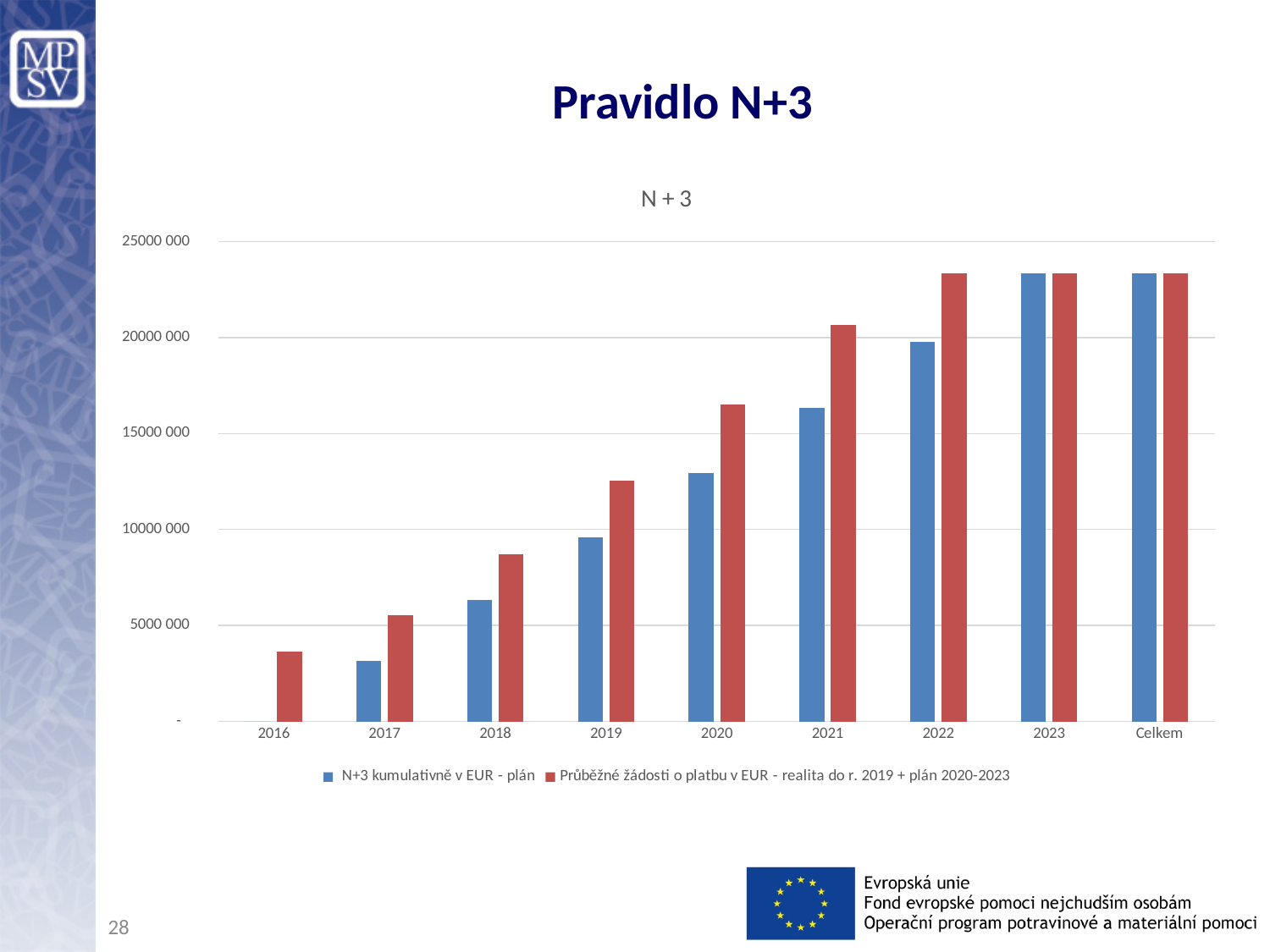
In 2019, which series has the larger value: 'N+3 kumulativně v EUR - plán' or 'Průběžné žádosti o platbu v EUR'? Průběžné žádosti o platbu v EUR What kind of chart is shown on the slide? bar chart Is the value for 'N+3 kumulativně v EUR - plán' in 2017 greater or less than 5000 000? less How many categories are shown on the x axis? 9 Is the value for 'Průběžné žádosti o platbu v EUR' in 2020 greater or less than 15000 000? greater What is the title of the chart? N + 3 Is the value for 'Průběžné žádosti o platbu v EUR' in 2021 greater or less than 20000 000? greater Do the values for 'N+3 kumulativně v EUR - plán' rise or fall from 2017 to 2023? rise Which category has the lowest value for the 'Průběžné žádosti o platbu v EUR' series? 2016 How many series does the legend list? 2 Which colour represents the series 'N+3 kumulativně v EUR - plán'? blue